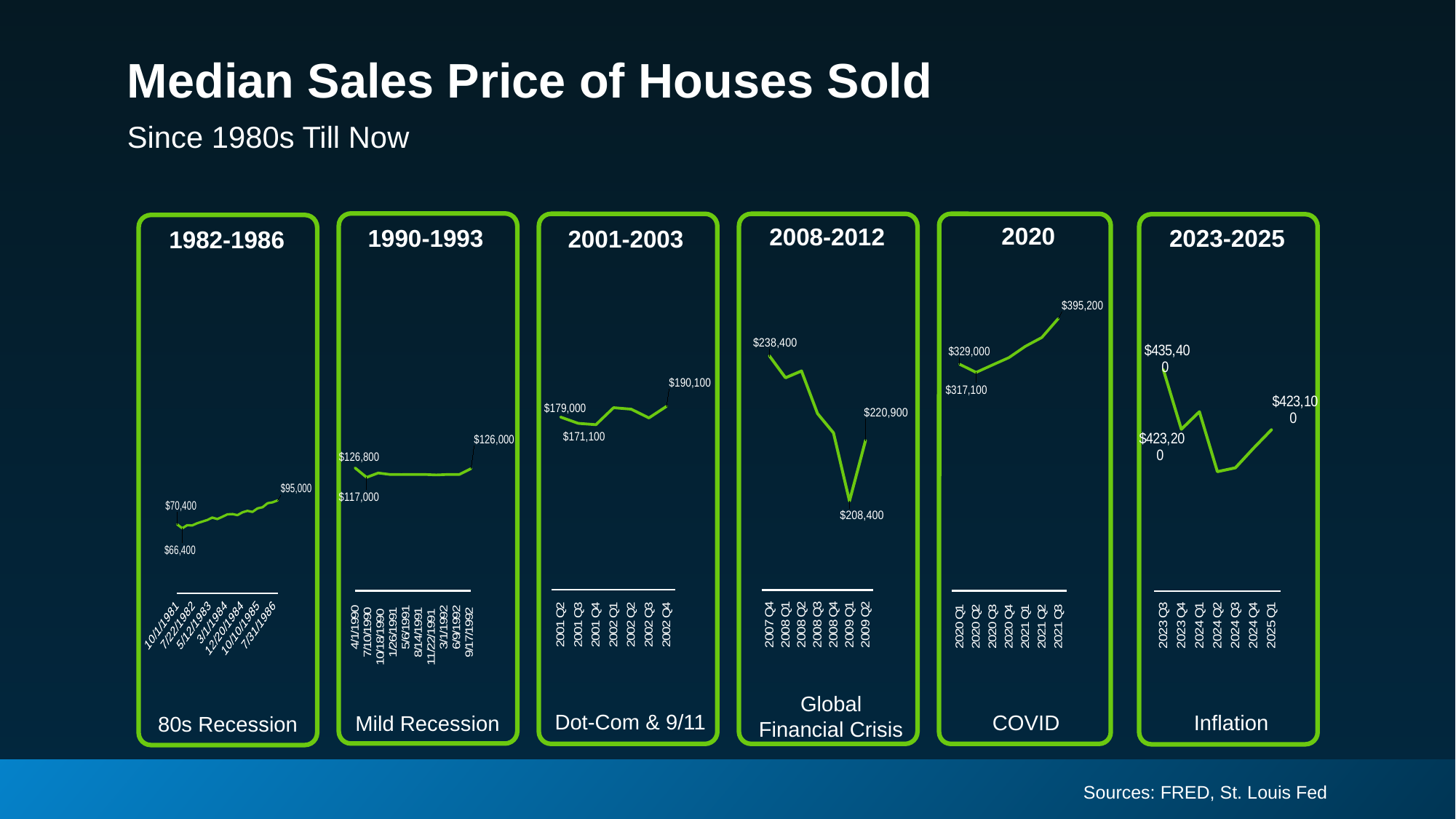
In the 1982-1986 chart, what is the value of the first labelled point? $70,400 What kind of chart is used in each of the six panels? Line chart In the 1982-1986 chart, what is the value of the last labelled point? $95,000 In the 2023-2025 chart, what is the value labelled at 2023 Q3? $435,400 In the 2008-2012 chart, what is the difference between the first labelled value ($238,400) and the lowest labelled value ($208,400)? $30,000 In the 2020 chart, do values rise or fall from 2020 Q2 to 2021 Q3? Rise In the 2020 chart, what is the highest labelled value? $395,200 In the 1990-1993 chart, what is the lowest labelled value? $117,000 In the 2008-2012 chart, what is the lowest labelled value? $208,400 In the 2001-2003 chart, what is the difference between the last labelled value ($190,100) and the first labelled value ($179,000)? $11,100 In the 2023-2025 chart, which is larger: the first labelled value or the last labelled value? The first labelled value ($435,400) How many x-axis points are shown in the 2001-2003 chart? 7